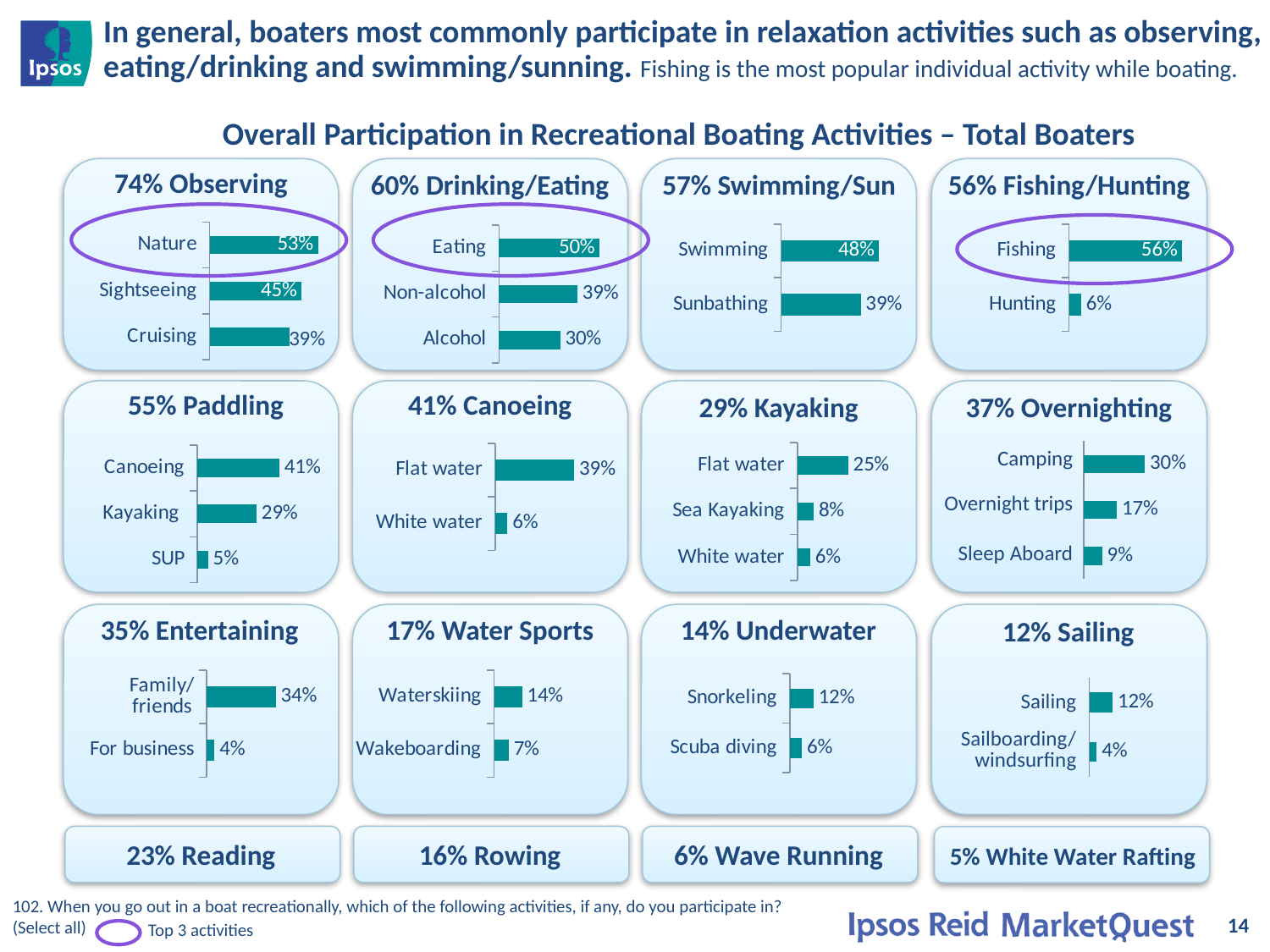
In the '41% Canoeing' chart, what is the difference between Flat water and White water? 33% In the '35% Entertaining' chart, what is the value for For business? 4% In the '37% Overnighting' chart, which category has the highest value? Camping In the '55% Paddling' chart, what is the difference between Canoeing and Kayaking? 12% In the '14% Underwater' chart, what is the value for Scuba diving? 6% In the '56% Fishing/Hunting' chart, which category has the lowest value? Hunting In the '57% Swimming/Sun' chart, which is larger, Swimming or Sunbathing? Swimming In the '60% Drinking/Eating' chart, what is the value for Alcohol? 30% In the '74% Observing' chart, what is the value for Nature? 53% What kind of chart is used in the '17% Water Sports' panel? Bar chart What is the overall title above the charts? Overall Participation in Recreational Boating Activities – Total Boaters In the '29% Kayaking' chart, how many categories are shown? 3